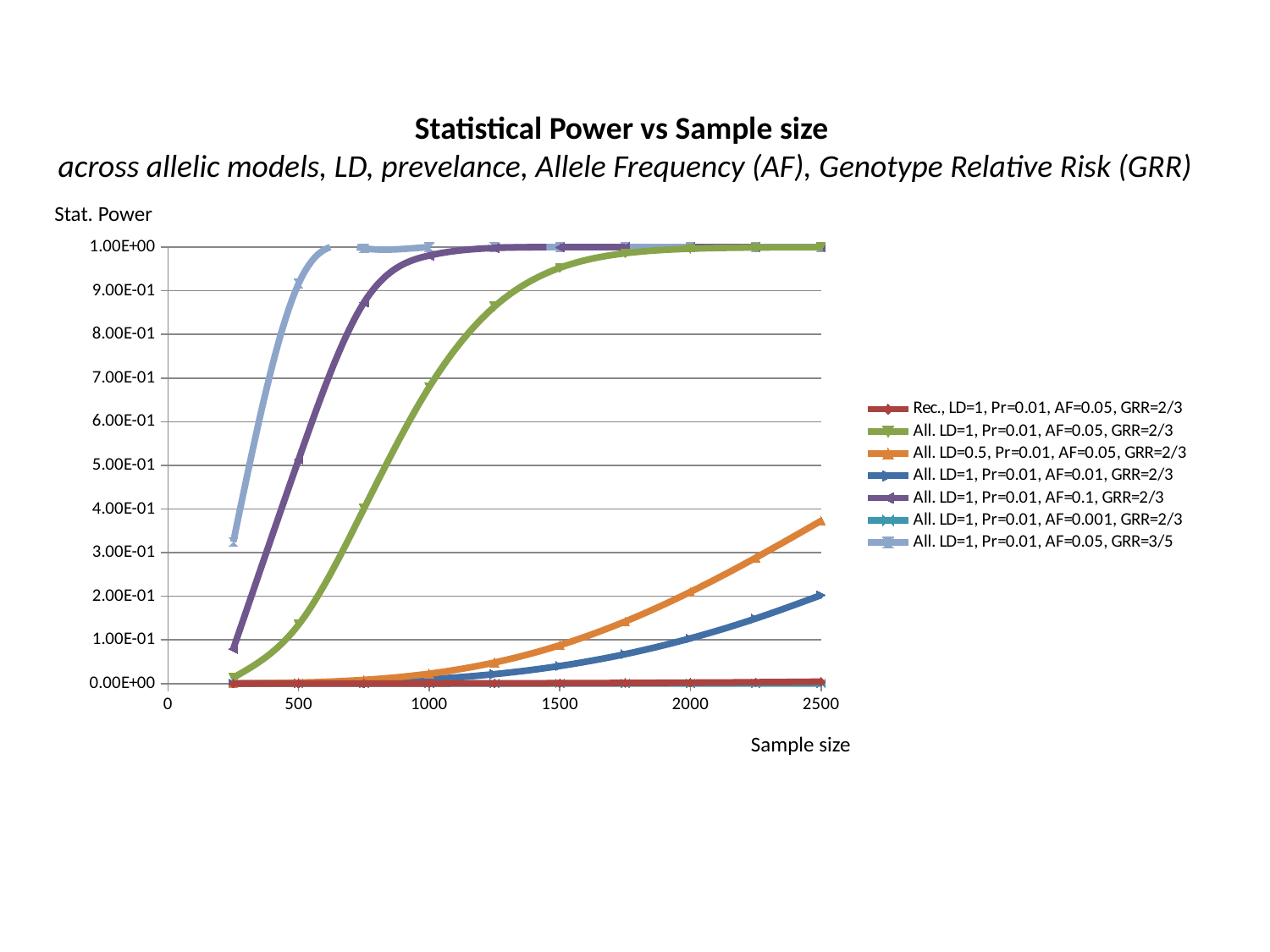
How many series does the legend list? 7 Is the value for 'All. LD=1, Pr=0.01, AF=0.05, GRR=2/3' at sample size 1000 greater or less than 5.00E-01? greater At sample size 2500, which series has the larger value: 'All. LD=0.5, Pr=0.01, AF=0.05, GRR=2/3' or 'All. LD=1, Pr=0.01, AF=0.01, GRR=2/3'? All. LD=0.5, Pr=0.01, AF=0.05, GRR=2/3 At sample size 1000, which series has the larger value: 'All. LD=1, Pr=0.01, AF=0.05, GRR=2/3' or 'All. LD=1, Pr=0.01, AF=0.1, GRR=2/3'? All. LD=1, Pr=0.01, AF=0.1, GRR=2/3 Is the value for 'All. LD=1, Pr=0.01, AF=0.05, GRR=3/5' at sample size 500 greater or less than 8.00E-01? greater What is the label of the x axis? Sample size Is the value for 'All. LD=0.5, Pr=0.01, AF=0.05, GRR=2/3' at sample size 2500 greater or less than 3.00E-01? greater What kind of chart is shown on the slide? line chart What is the title of the chart? Statistical Power vs Sample size Does the value for 'All. LD=0.5, Pr=0.01, AF=0.05, GRR=2/3' rise or fall as sample size increases? rise